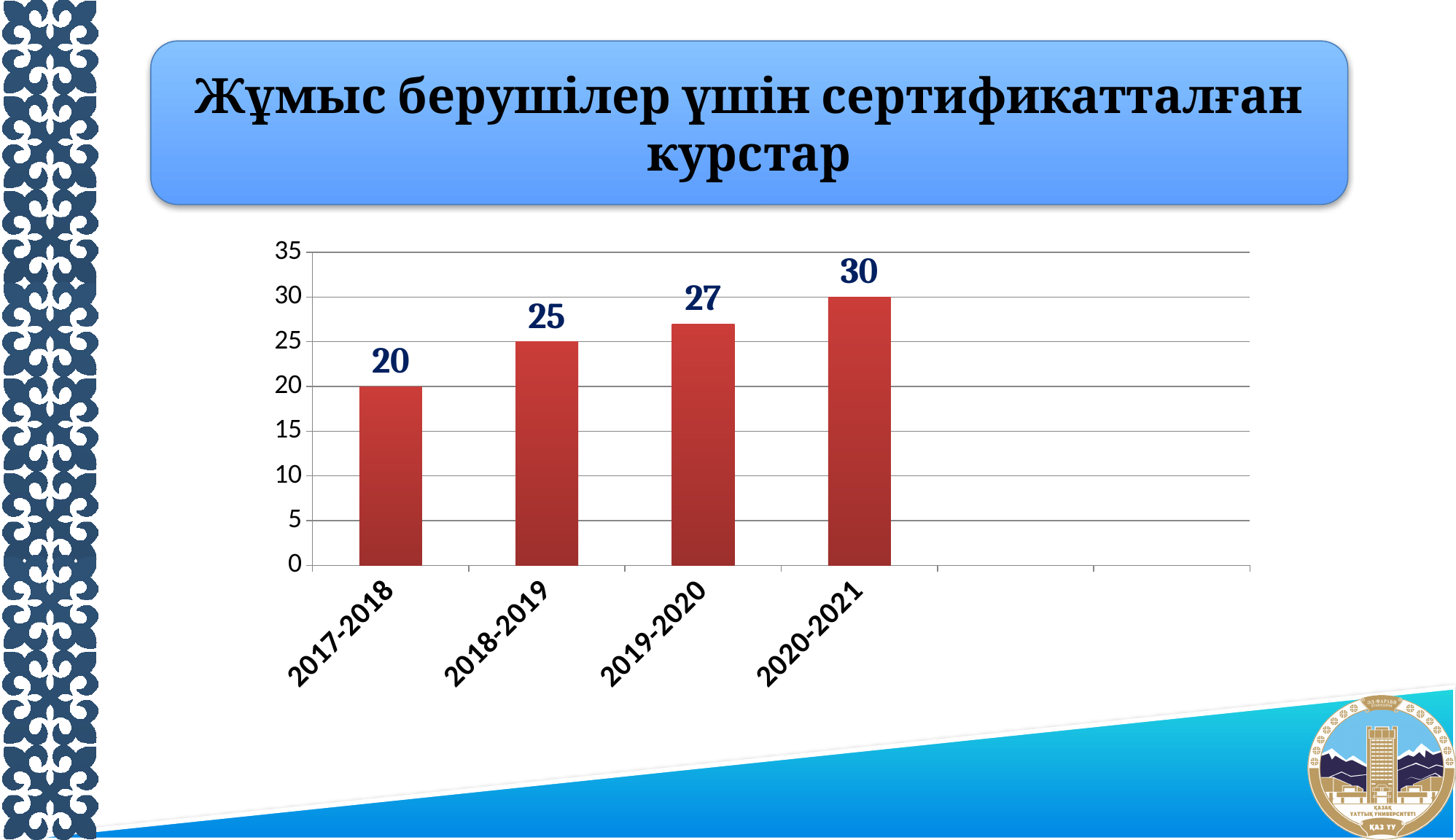
Do the values rise or fall from 2017-2018 to 2020-2021? rise What is the value for 2019-2020? 27 Which period has the highest value? 2020-2021 How many periods are shown on the x axis with bars? 4 Which is larger, the value for 2018-2019 or the value for 2019-2020? 2019-2020 What kind of chart is shown on the slide? bar chart What is the value for 2017-2018? 20 What is the value for 2018-2019? 25 What is the difference between the values for 2020-2021 and 2017-2018? 10 What is the value for 2020-2021? 30 Is the value for 2019-2020 greater or less than 25? greater Which period has the lowest value? 2017-2018